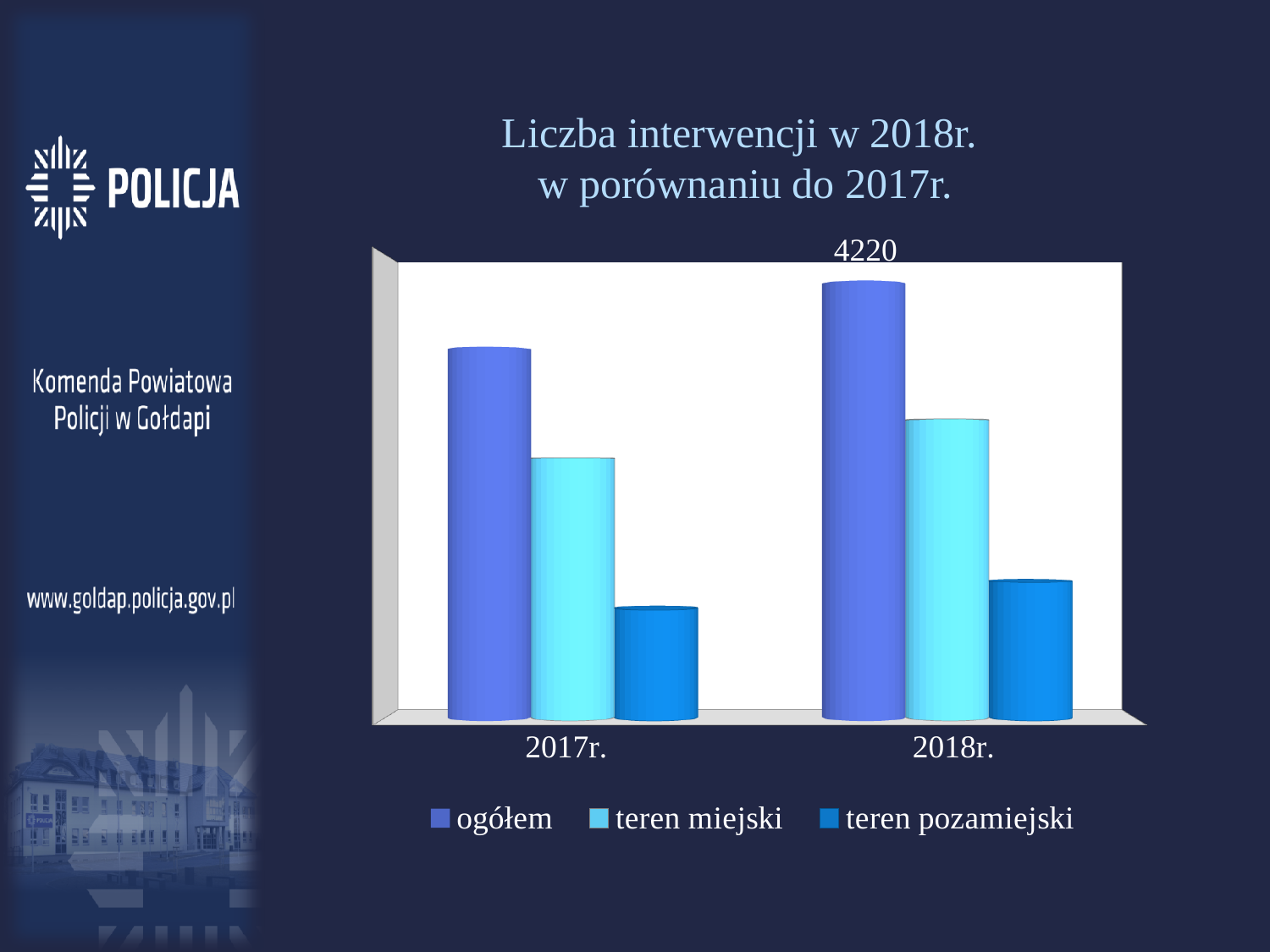
Which series has the highest bar for 2018r.? ogółem What is the title of the chart? Liczba interwencji w 2018r. w porównaniu do 2017r. How many series does the legend list? 3 How many categories (years) are shown on the x axis? 2 What kind of chart is shown on the slide? bar chart Which is larger for 2018r.: teren miejski or teren pozamiejski? teren miejski Is the ogółem bar larger for 2017r. or for 2018r.? 2018r. Which series has the lowest bar for 2017r.? teren pozamiejski Does the ogółem value rise or fall from 2017r. to 2018r.? rise Is the teren miejski bar larger for 2017r. or for 2018r.? 2018r. What is the value of the ogółem bar for 2018r.? 4220 Which series is shown in the darkest blue colour in the legend? teren pozamiejski